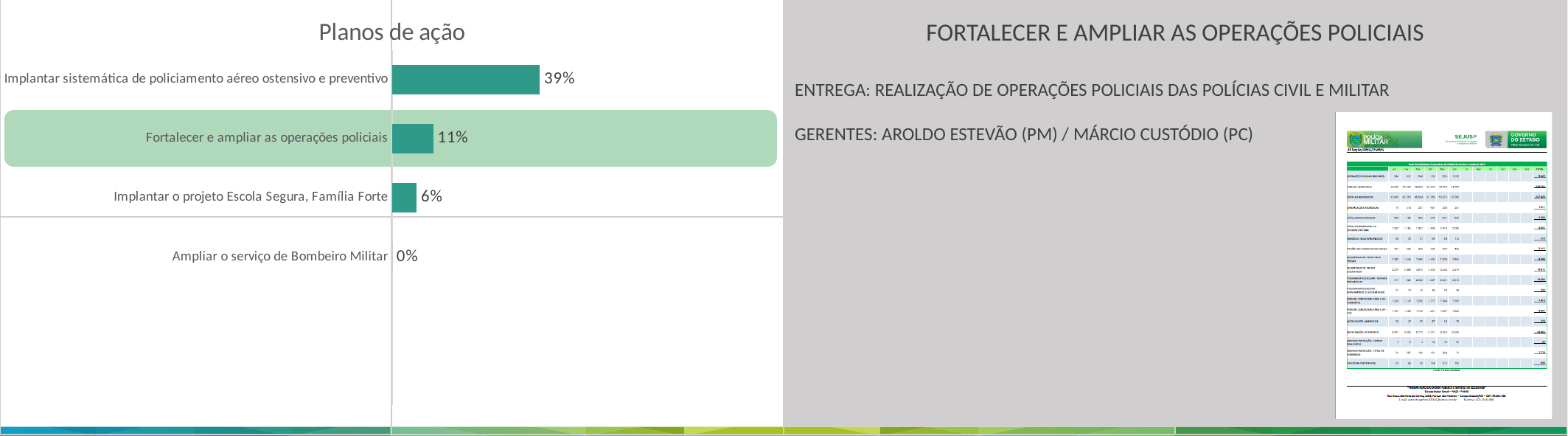
Which is larger in the Planos de ação chart: the value for "Fortalecer e ampliar as operações policiais" or for "Implantar o projeto Escola Segura, Família Forte"? Fortalecer e ampliar as operações policiais How many categories are shown in the Planos de ação chart? 4 What is the value for "Ampliar o serviço de Bombeiro Militar" in the Planos de ação chart? 0% What is the difference between the values for "Fortalecer e ampliar as operações policiais" and "Implantar o projeto Escola Segura, Família Forte" in the Planos de ação chart? 5% What kind of chart is the Planos de ação chart? Bar chart What is the value for "Implantar o projeto Escola Segura, Família Forte" in the Planos de ação chart? 6% What is the value for "Fortalecer e ampliar as operações policiais" in the Planos de ação chart? 11% What is the title of the chart on the left side of the slide? Planos de ação Which category has the lowest value in the Planos de ação chart? Ampliar o serviço de Bombeiro Militar Which category has the highest value in the Planos de ação chart? Implantar sistemática de policiamento aéreo ostensivo e preventivo What is the value for "Implantar sistemática de policiamento aéreo ostensivo e preventivo" in the Planos de ação chart? 39% What is the difference between the values for "Implantar sistemática de policiamento aéreo ostensivo e preventivo" and "Fortalecer e ampliar as operações policiais" in the Planos de ação chart? 28%